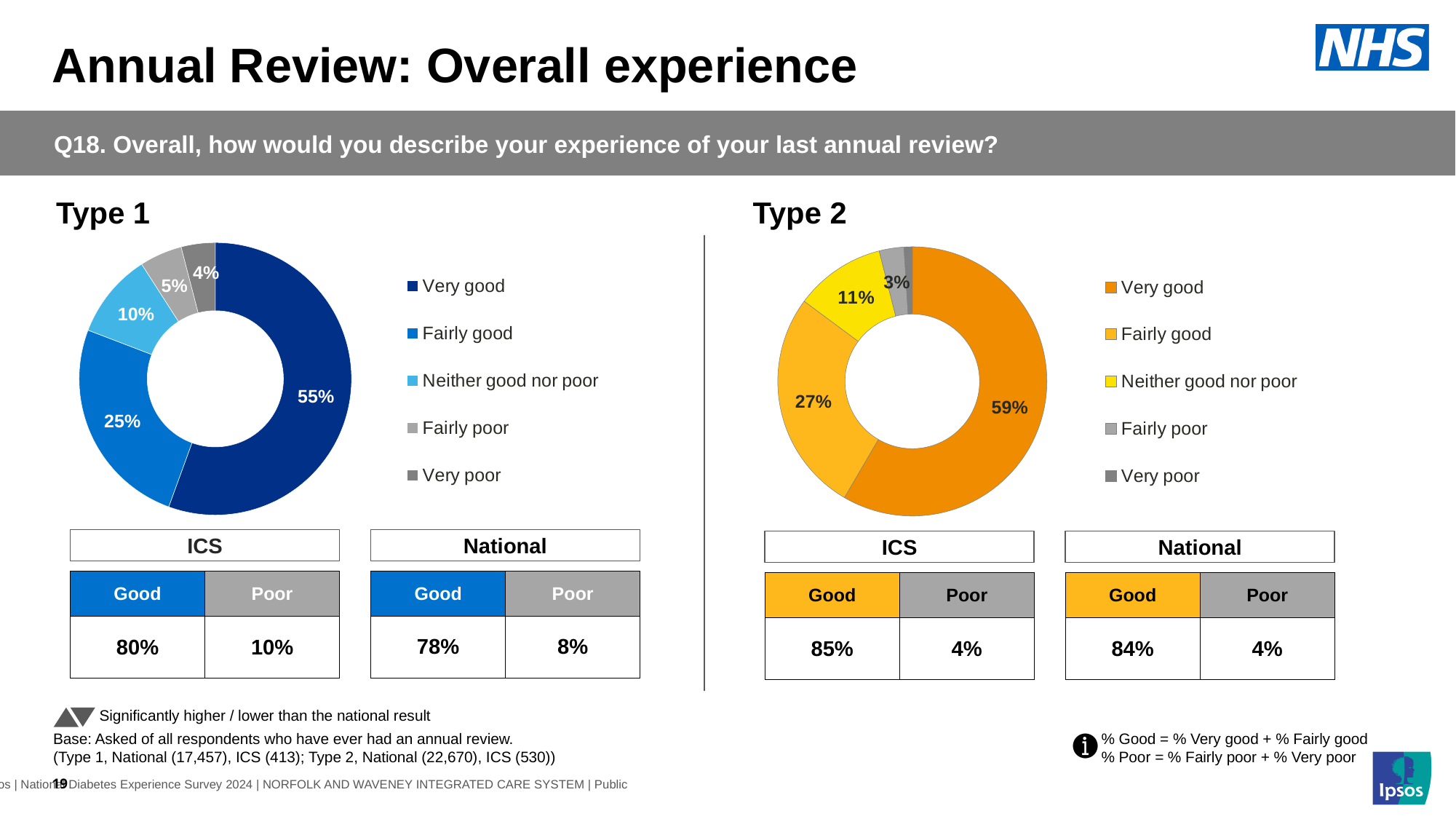
What colour represents 'Neither good nor poor' in the Type 2 chart? Yellow In the Type 1 chart, what is the difference between the 'Very good' and 'Fairly good' shares? 30 percentage points In the Type 1 chart, what is the combined share of 'Fairly poor' and 'Very poor'? 9% What kind of chart is used to show the Type 2 results? Donut (pie) chart How many response categories does the legend of the Type 1 chart list? 5 In the Type 1 chart, what percentage of respondents said their experience was 'Very good'? 55% In the Type 2 chart, what percentage of respondents said 'Fairly poor'? 3% Which is larger: the 'Very good' share in the Type 1 chart or the 'Very good' share in the Type 2 chart? Type 2 In the Type 2 chart, which response category has the smallest share? Very poor In the Type 1 chart, which response category has the largest share? Very good In the Type 1 chart, what percentage of respondents said 'Neither good nor poor'? 10% In the Type 2 chart, what percentage of respondents said their experience was 'Fairly good'? 27%